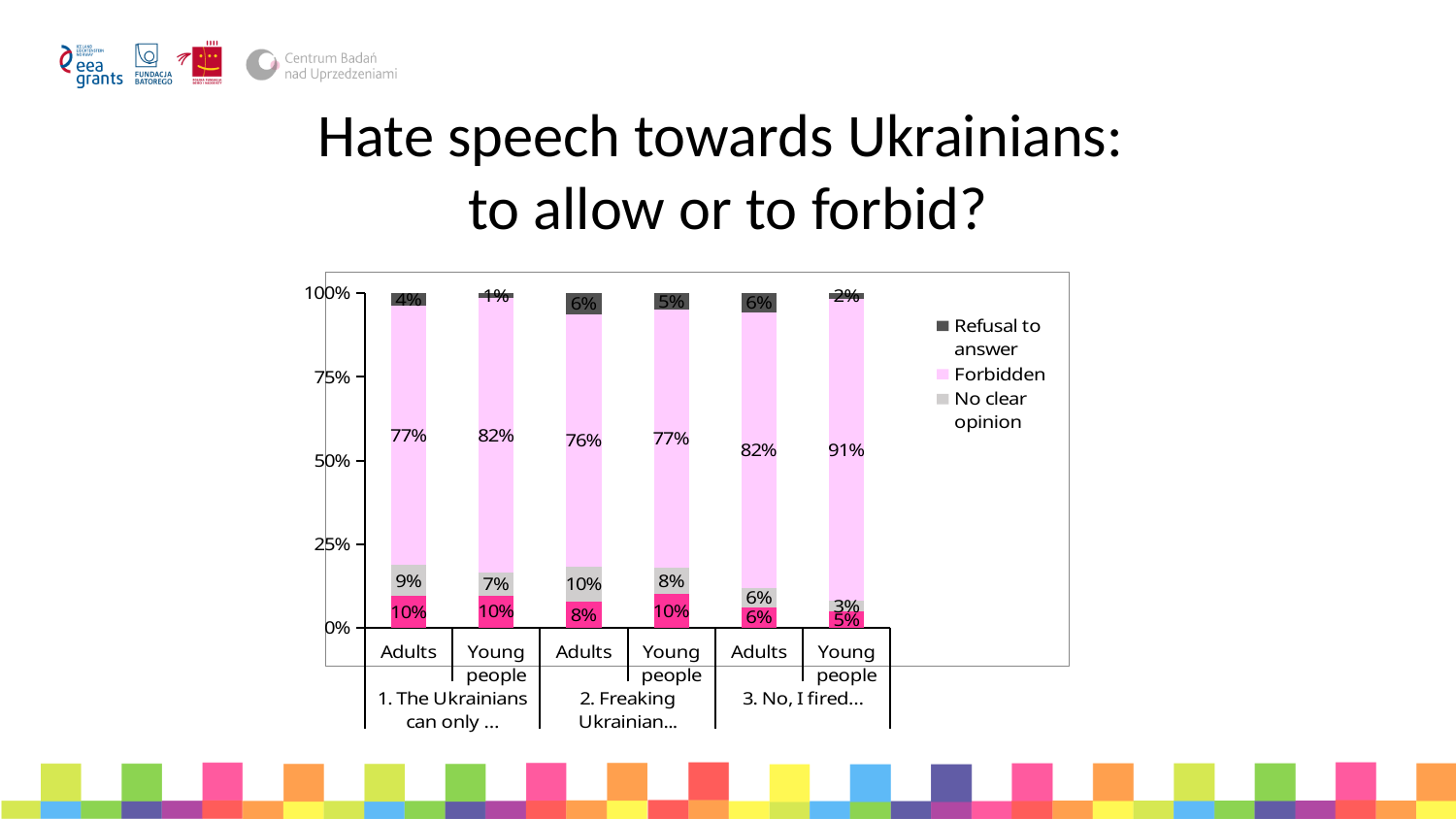
How many bars are plotted in the chart? 6 What is the title of the slide? Hate speech towards Ukrainians: to allow or to forbid? What is the "No clear opinion" share for young people under statement "1. The Ukrainians can only ..."? 7% How many series does the legend list? 3 Which group and statement has the lowest "Forbidden" share? Adults, 2. Freaking Ukrainian... What percentage of young people chose "Forbidden" for statement "3. No, I fired..."? 91% Which group and statement has the highest "Forbidden" share? Young people, 3. No, I fired... For statement "1. The Ukrainians can only ...", is the "Forbidden" share larger for adults or for young people? Young people For statement "3. No, I fired...", how many percentage points higher is the "Forbidden" share for young people than for adults? 9 percentage points What is the "Refusal to answer" share for adults under statement "2. Freaking Ukrainian..."? 6% What kind of chart is shown on the slide? Stacked bar chart What percentage of adults chose "Forbidden" for statement "1. The Ukrainians can only ..."? 77%